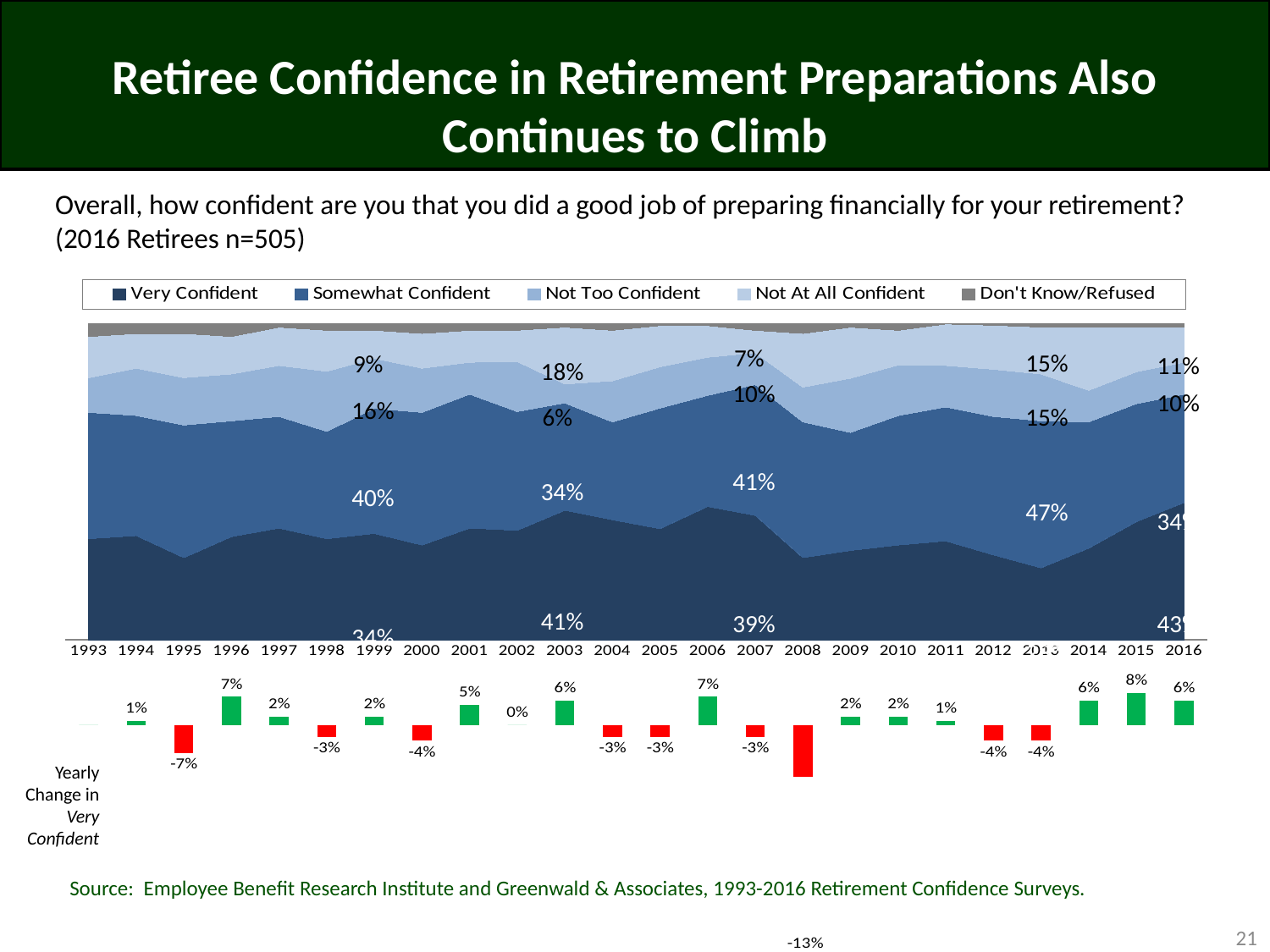
In the top chart, what is the Somewhat Confident value for 1999? 40% What kind of chart is the bottom chart showing the yearly change in Very Confident? Bar chart In the bottom chart, which year has the lowest yearly change in Very Confident? 2008 In the bottom chart, which year has the highest yearly change in Very Confident? 2015 In the bottom chart, what is the yearly change in Very Confident for 2015? 8% What kind of chart is the top chart on the slide? Stacked area chart In the top chart, what is the Not Too Confident value for 2003? 6% How many series does the legend of the top chart list? 5 In the bottom chart, is the yearly change in Very Confident larger for 2006 or 2007? 2006 In the top chart, what is the Not At All Confident value for 2007? 7% In the top chart, what is the Somewhat Confident value for 2013? 47% In the top chart, what is the difference between the Not At All Confident values for 2003 and 2007? 11 percentage points